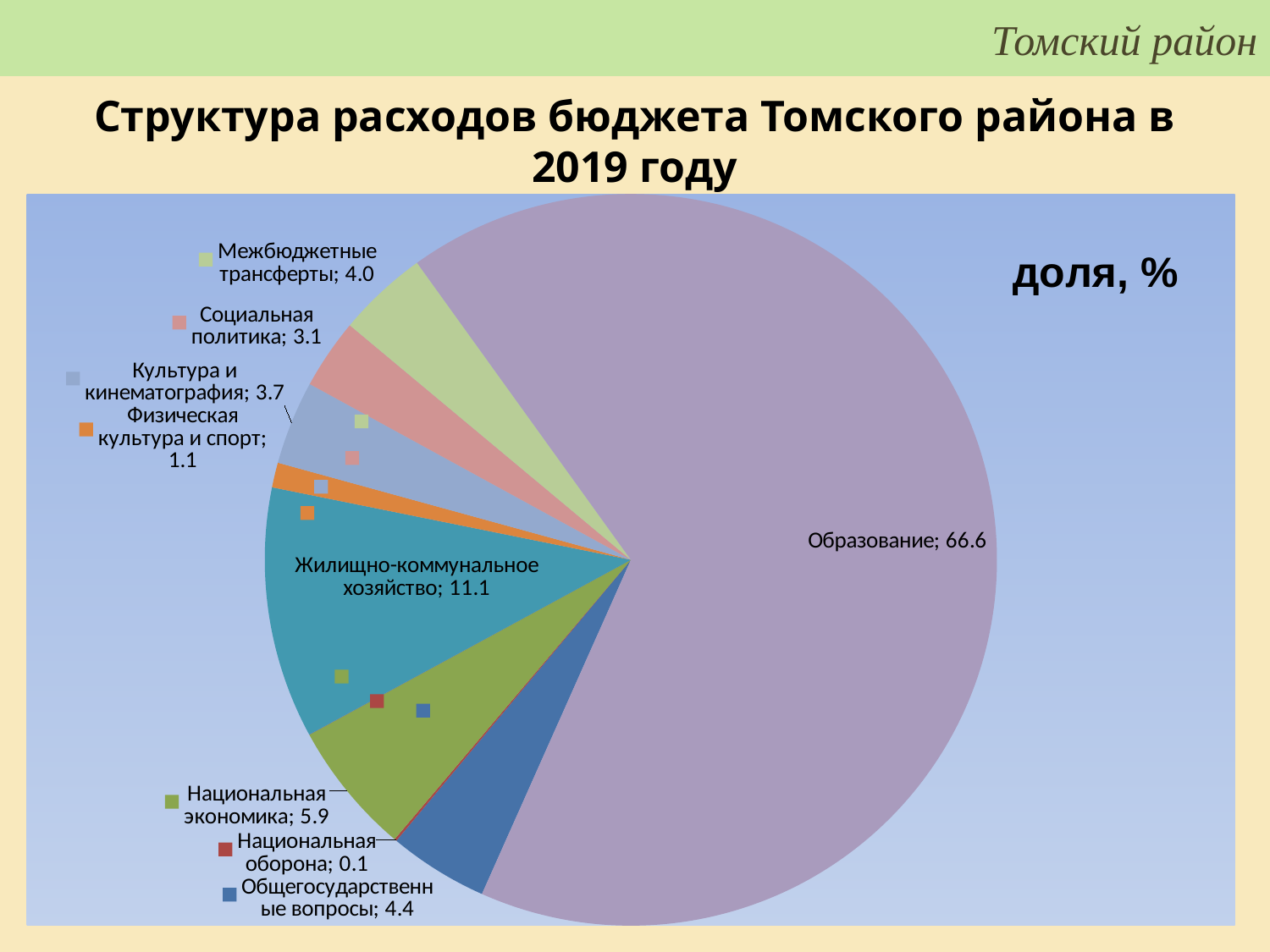
What is the share for Физическая культура и спорт? 1.1 What is the difference between the shares of Образование and Жилищно-коммунальное хозяйство? 55.5 What is the title of the chart on the slide? доля, % Which category has the largest share of the pie? Образование What is the share for Общегосударственные вопросы? 4.4 What kind of chart is shown on the slide? Pie chart What is the share for Национальная экономика? 5.9 What is the share for Жилищно-коммунальное хозяйство? 11.1 How many categories are shown in the pie chart? 9 Which is larger: the share for Межбюджетные трансферты or the share for Социальная политика? Межбюджетные трансферты What is the share for Образование? 66.6